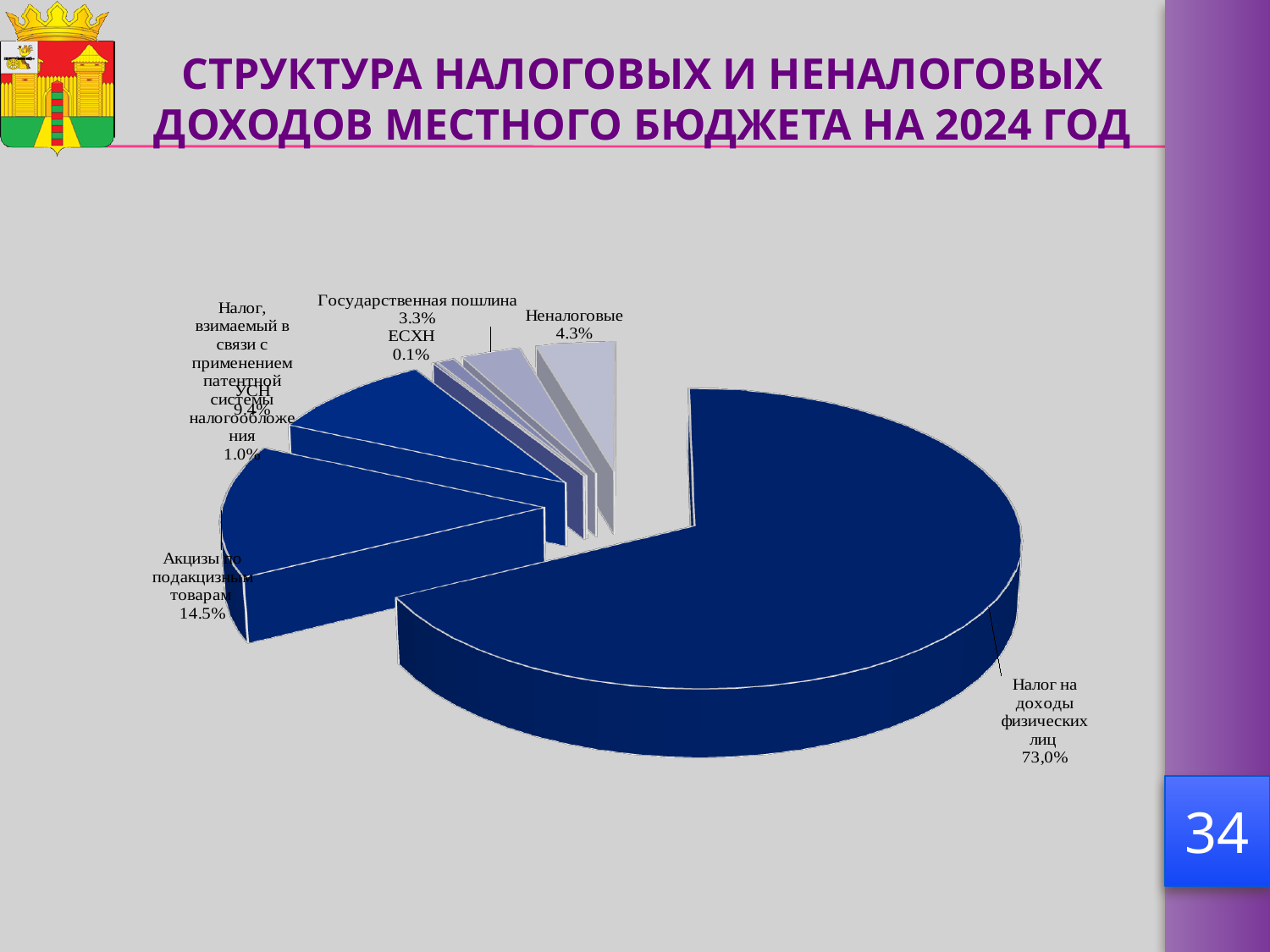
What is the value shown for "Акцизы по подакцизным товарам"? 14.5% What is the value shown for "Неналоговые"? 4.3% What is the difference between the shares for "Акцизы по подакцизным товарам" and "УСН"? 5.1% What type of chart is shown on the slide? pie chart Which category has the smallest share of the pie? ЕСХН Which category has the largest share of the pie? Налог на доходы физических лиц What is the value shown for "ЕСХН"? 0.1% What is the value shown for "УСН"? 9.4% How many slices does the pie chart have? 7 What share of the pie does "Налог на доходы физических лиц" have? 73,0% What is the value shown for "Государственная пошлина"? 3.3% Which is larger: the share for "Неналоговые" or the share for "Государственная пошлина"? Неналоговые